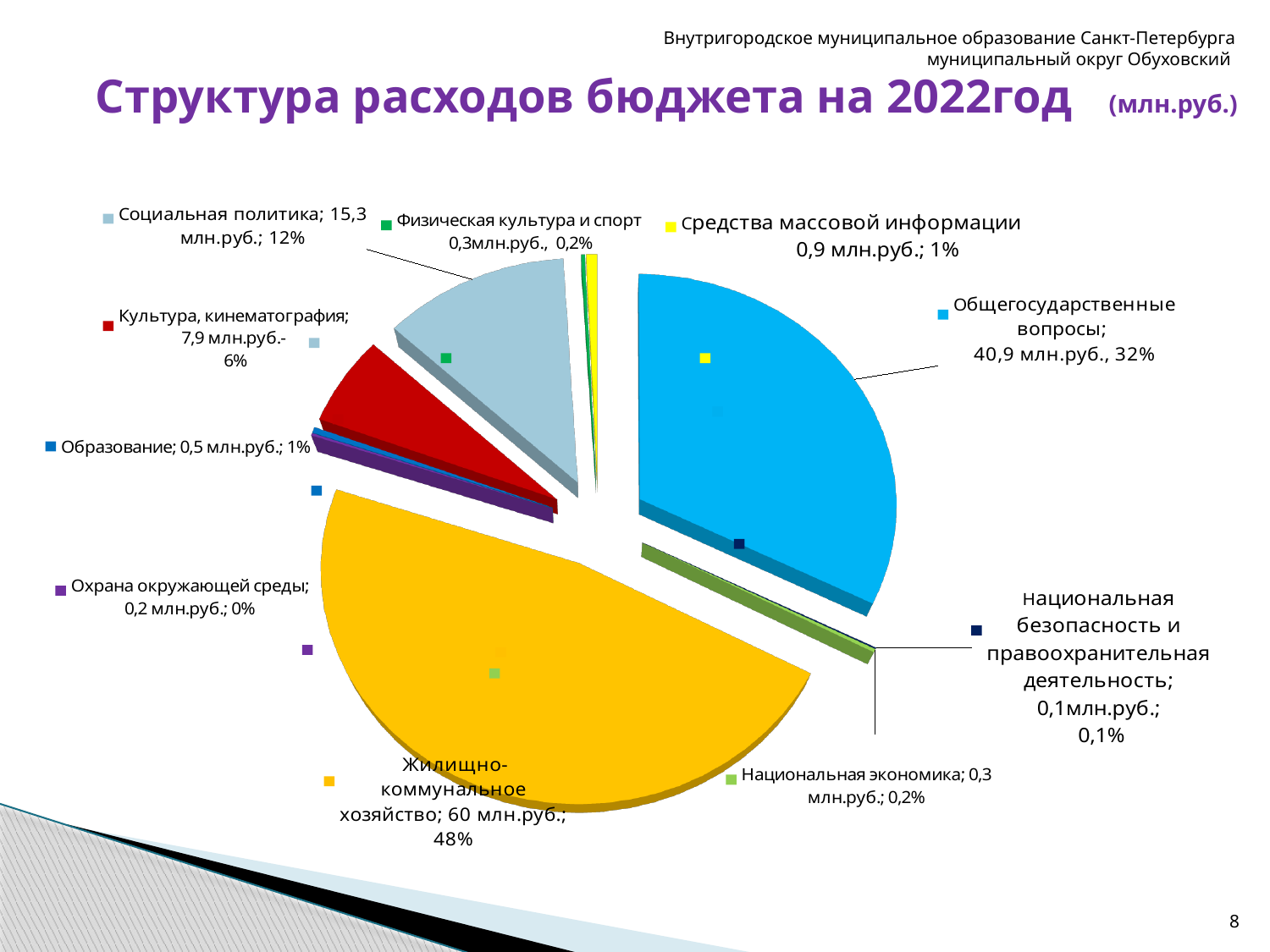
What is the difference between the values for Жилищно-коммунальное хозяйство and Общегосударственные вопросы? 19,1 млн.руб. What share of the pie does Общегосударственные вопросы take? 32% Which category has the largest share of the pie? Жилищно-коммунальное хозяйство Which category has the smallest value? национальная безопасность и правоохранительная деятельность How many categories does the pie chart show? 10 What is the value for Жилищно-коммунальное хозяйство? 60 млн.руб. What is the value for Средства массовой информации? 0,9 млн.руб. What is the title of the chart? Структура расходов бюджета на 2022год (млн.руб.) What is the value for Социальная политика? 15,3 млн.руб. What share of the pie does Культура, кинематография take? 6% Which is larger, the value for Социальная политика or the value for Культура, кинематография? Социальная политика What kind of chart is shown on the slide? pie chart